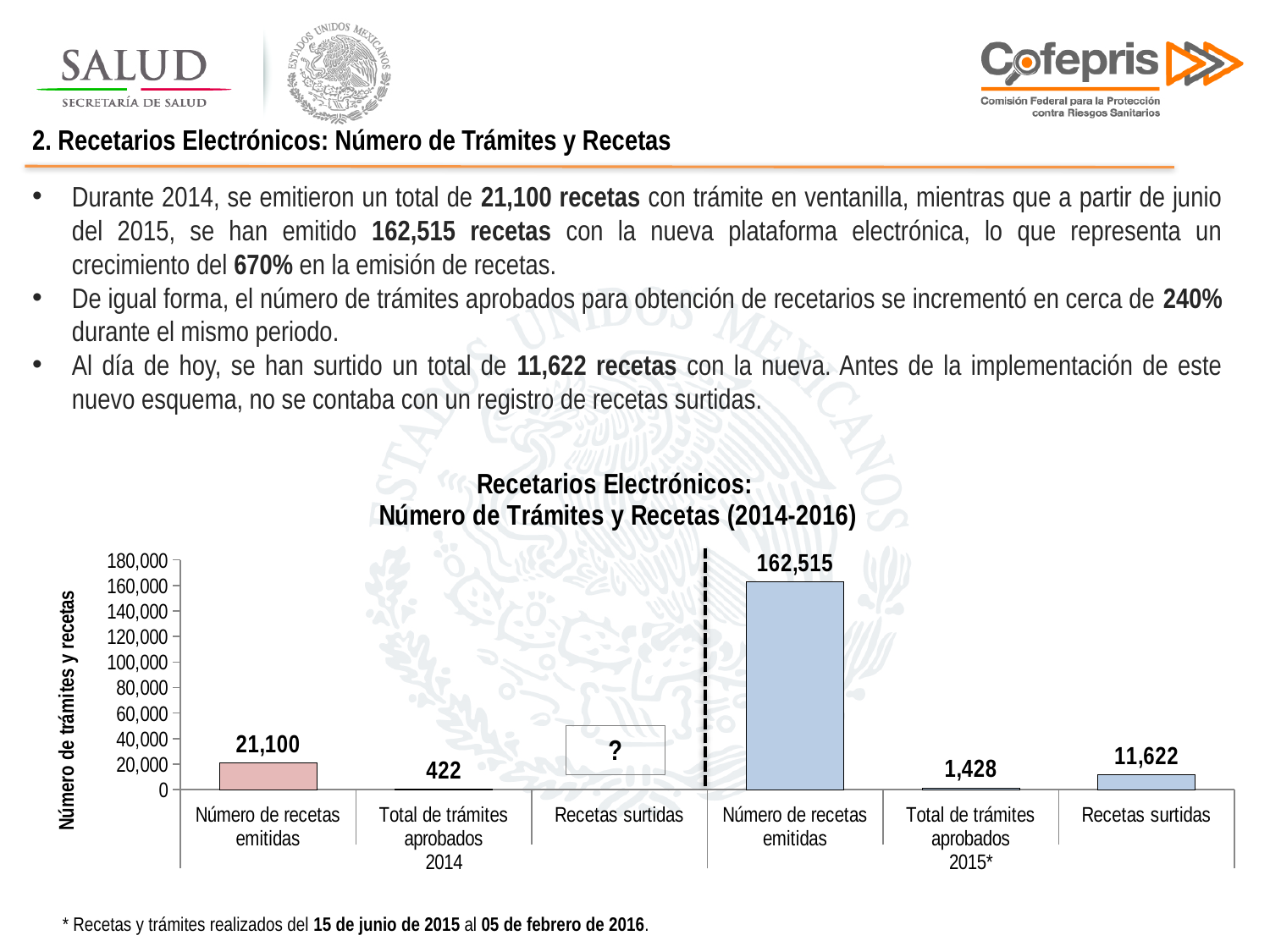
What is the value for Total de trámites aprobados in 2015*? 1,428 What is the value for Recetas surtidas in 2015*? 11,622 What type of chart is shown on the slide? bar chart What is the difference between Número de recetas emitidas in 2015* and in 2014? 141,415 What is the value for Total de trámites aprobados in 2014? 422 What label is shown for Recetas surtidas in 2014 instead of a value? ? What is the value for Número de recetas emitidas in 2015*? 162,515 What is the difference between Total de trámites aprobados in 2015* and in 2014? 1,006 Which bar has the highest value in the chart? Número de recetas emitidas (2015*) Is the value for Número de recetas emitidas in 2015* greater or less than 140,000? greater What is the value for Número de recetas emitidas in 2014? 21,100 Which is larger: Recetas surtidas in 2015* or Total de trámites aprobados in 2015*? Recetas surtidas in 2015*